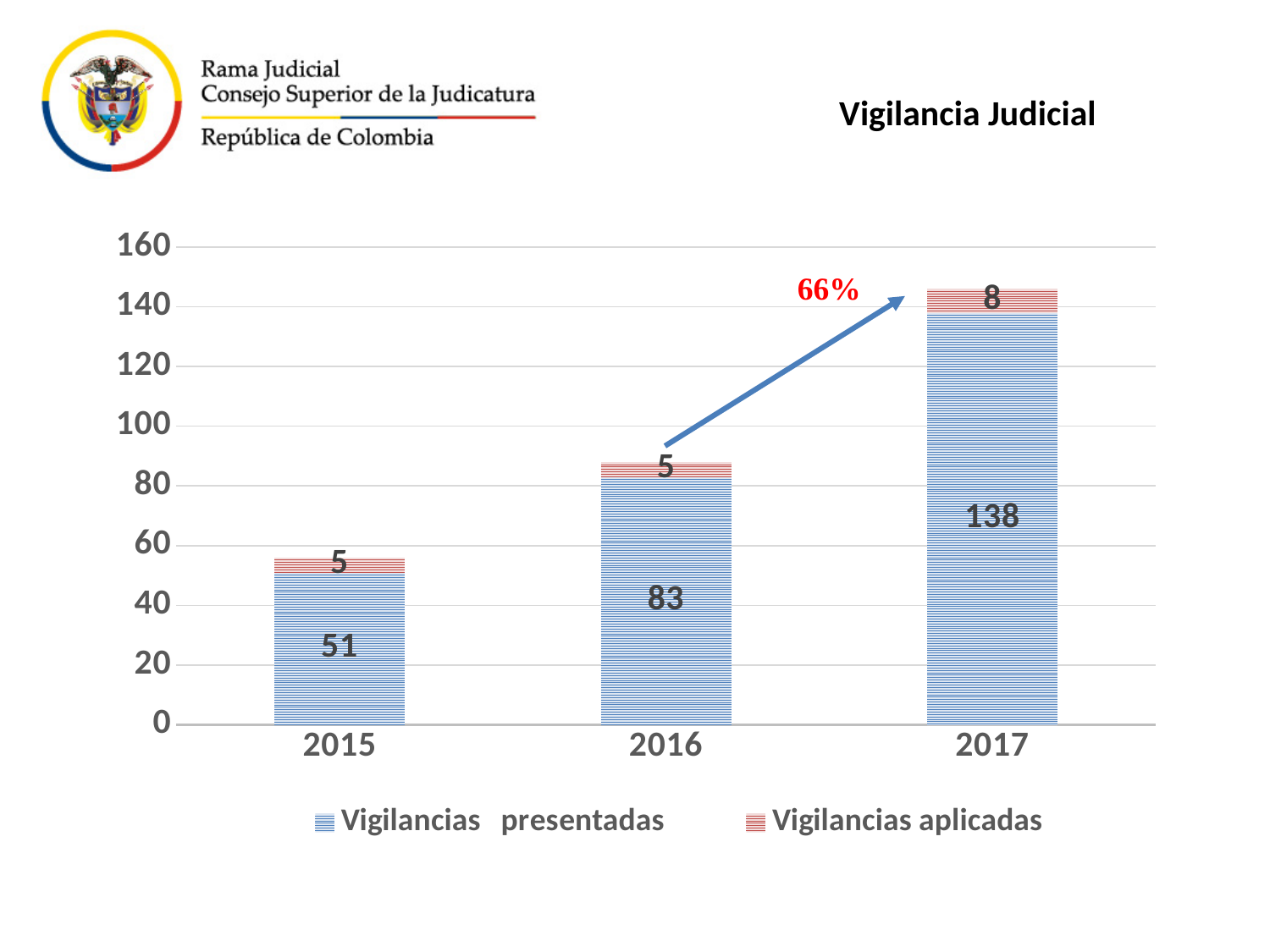
Which is larger, Vigilancias aplicadas in 2017 or in 2015? 2017 What is the value of Vigilancias presentadas for 2017? 138 What is the value of Vigilancias presentadas for 2015? 51 How many series does the legend list? 2 What is the difference between Vigilancias presentadas in 2017 and 2016? 55 What is the value of Vigilancias aplicadas for 2016? 5 What kind of chart is shown on the slide? Stacked bar chart What is the total of the stacked bar for 2017? 146 What is the total of the stacked bar for 2016? 88 Which year has the highest value for Vigilancias presentadas? 2017 Which year has the lowest value for Vigilancias presentadas? 2015 How many years are shown on the x axis? 3